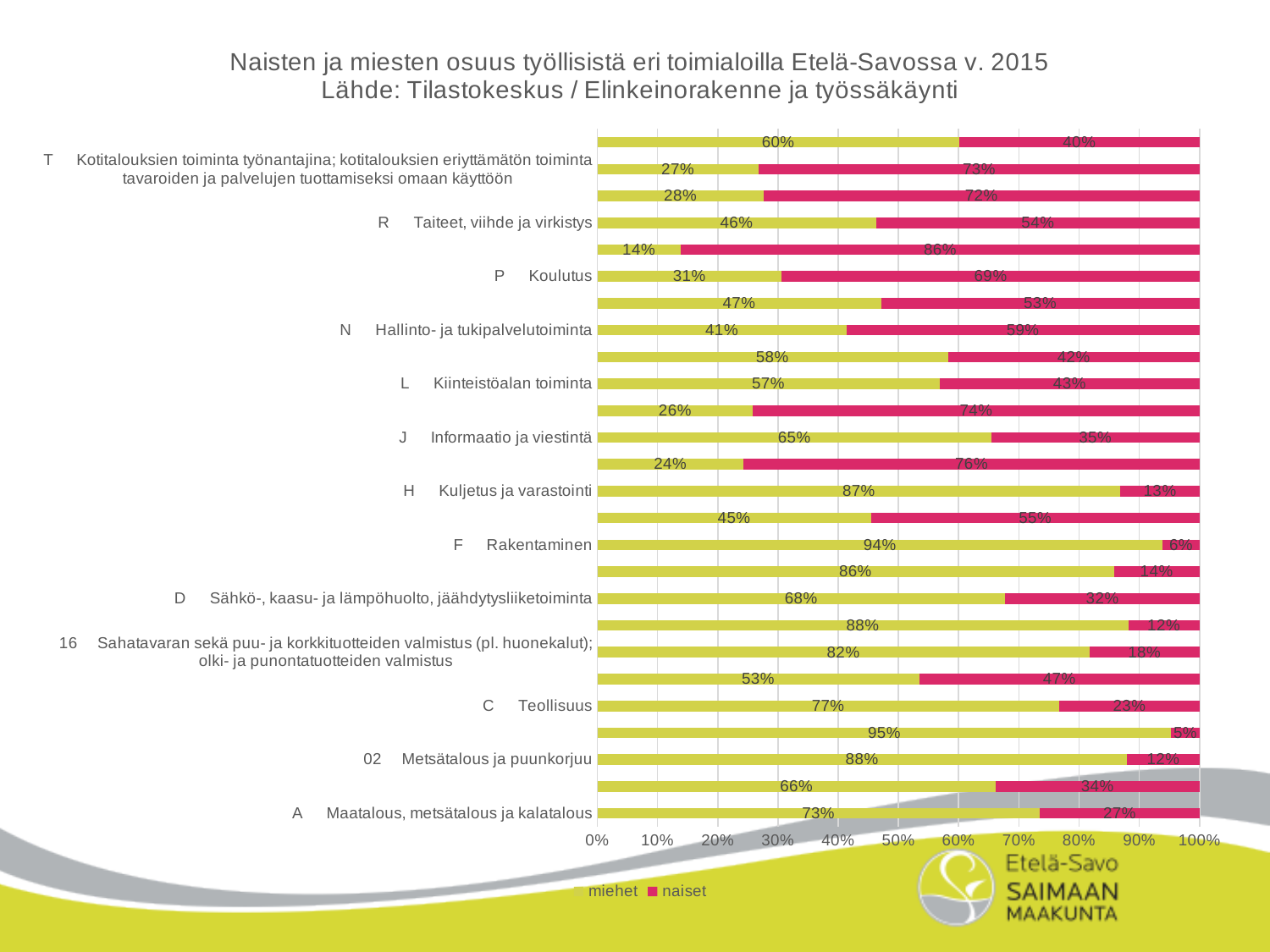
What is the naiset share for Maatalous, metsätalous ja kalatalous? 27% What is the naiset share for Koulutus? 69% Which has a larger naiset share, Koulutus or Hallinto- ja tukipalvelutoiminta? Koulutus What share of employed persons in Rakentaminen are miehet? 94% How many series does the legend list? 2 What is the miehet share for Kuljetus ja varastointi? 87% What is the naiset share for Taiteet, viihde ja virkistys? 54% What kind of chart is shown on the slide? Stacked bar chart What is the total of the stacked bar for Koulutus? 100% Is the miehet share for Kiinteistöalan toiminta greater or less than 50%? greater For Informaatio ja viestintä, how many percentage points larger is the miehet share than the naiset share? 30 percentage points Which has a larger miehet share, Teollisuus or Metsätalous ja puunkorjuu? Metsätalous ja puunkorjuu